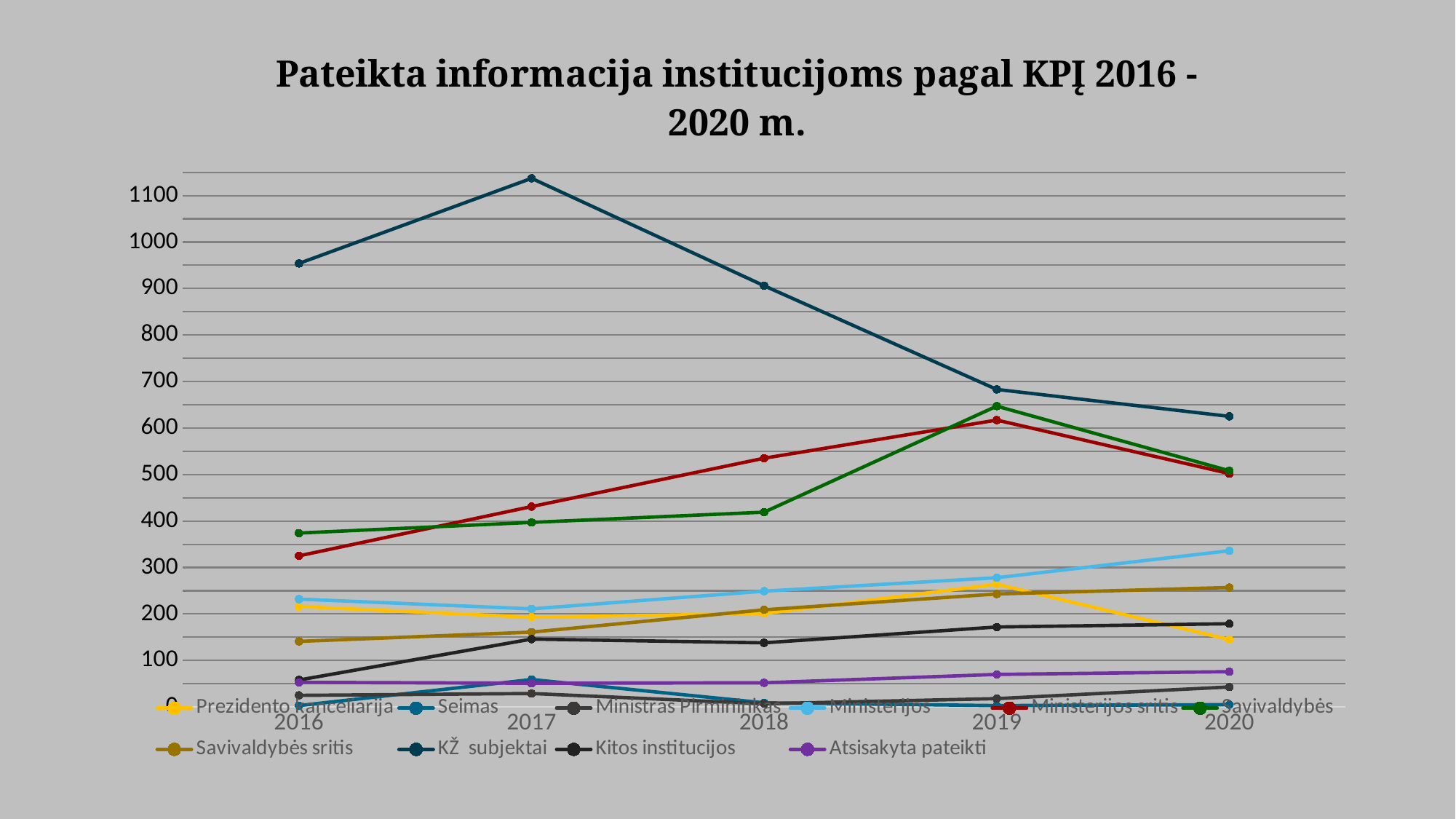
Does the KŽ subjektai series rise or fall from 2017 to 2020? fall In which year does the KŽ subjektai series reach its highest value? 2017 In which year is the Prezidento kanceliarija series at its lowest? 2020 Is the value for Atsisakyta pateikti in 2020 greater or less than 100? less Which is larger in 2020: KŽ subjektai or Savivaldybės? KŽ subjektai How many series does the legend list? 10 Is the value for Savivaldybės in 2019 greater or less than 600? greater Is the value for KŽ subjektai in 2017 greater or less than 1000? greater What kind of chart is shown on the slide? line chart Which series has the highest value in 2017? KŽ subjektai How many years are shown on the x axis? 5 Which is larger in 2018: Ministerijos sritis or Savivaldybės? Ministerijos sritis